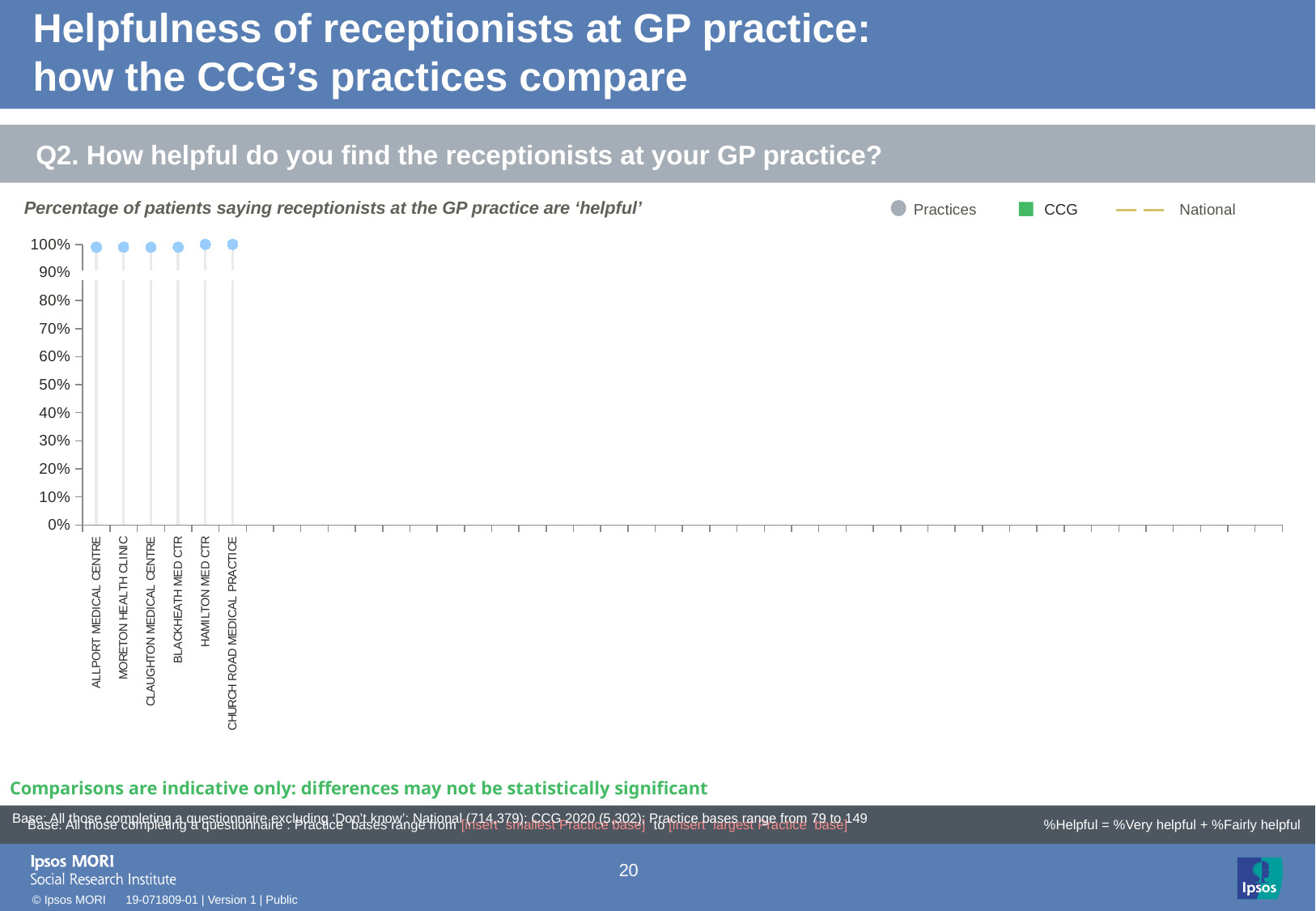
What does the chart measure, according to the subtitle above it? Percentage of patients saying receptionists at the GP practice are 'helpful' Is the value for MORETON HEALTH CLINIC greater or less than 90%? greater What are the three entries in the chart legend? Practices, CCG, National Is the value for CLAUGHTON MEDICAL CENTRE greater or less than 60%? greater How many series does the chart legend list? 3 Is the value for HAMILTON MED CTR greater or less than 80%? greater How many practices are plotted on the chart? 6